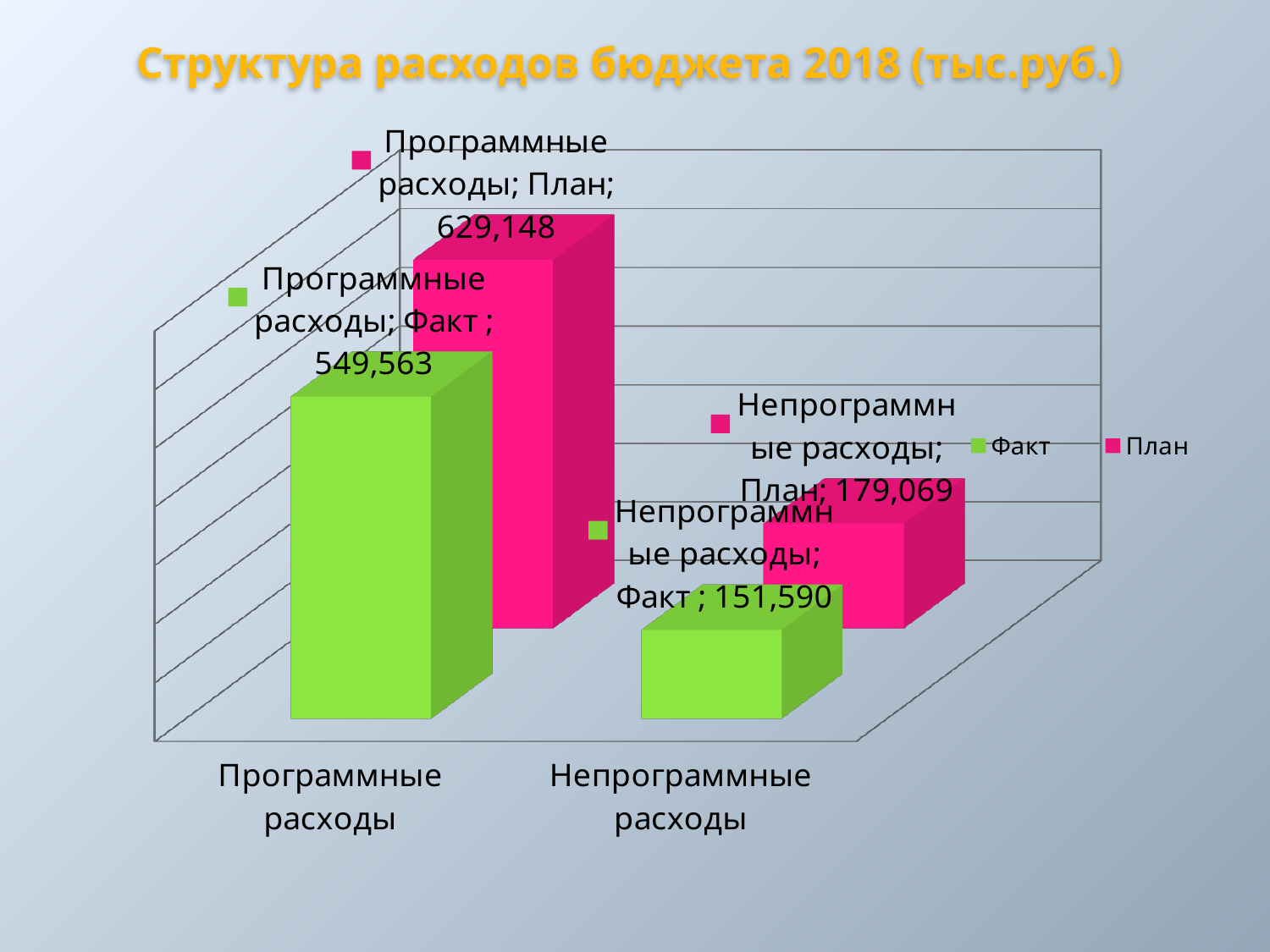
Which bar has the lowest value on the chart? Непрограммные расходы, Факт What is the difference between План and Факт for Программные расходы? 79,585 What is the План value for Программные расходы? 629,148 What type of chart is shown on the slide? Bar chart Which is larger for Непрограммные расходы: План or Факт? План What is the difference between План and Факт for Непрограммные расходы? 27,479 What is the Факт value for Непрограммные расходы? 151,590 What is the План value for Непрограммные расходы? 179,069 How many series does the legend list? 2 What is the Факт value for Программные расходы? 549,563 How many categories are shown on the x axis? 2 Which bar has the highest value on the chart? Программные расходы, План